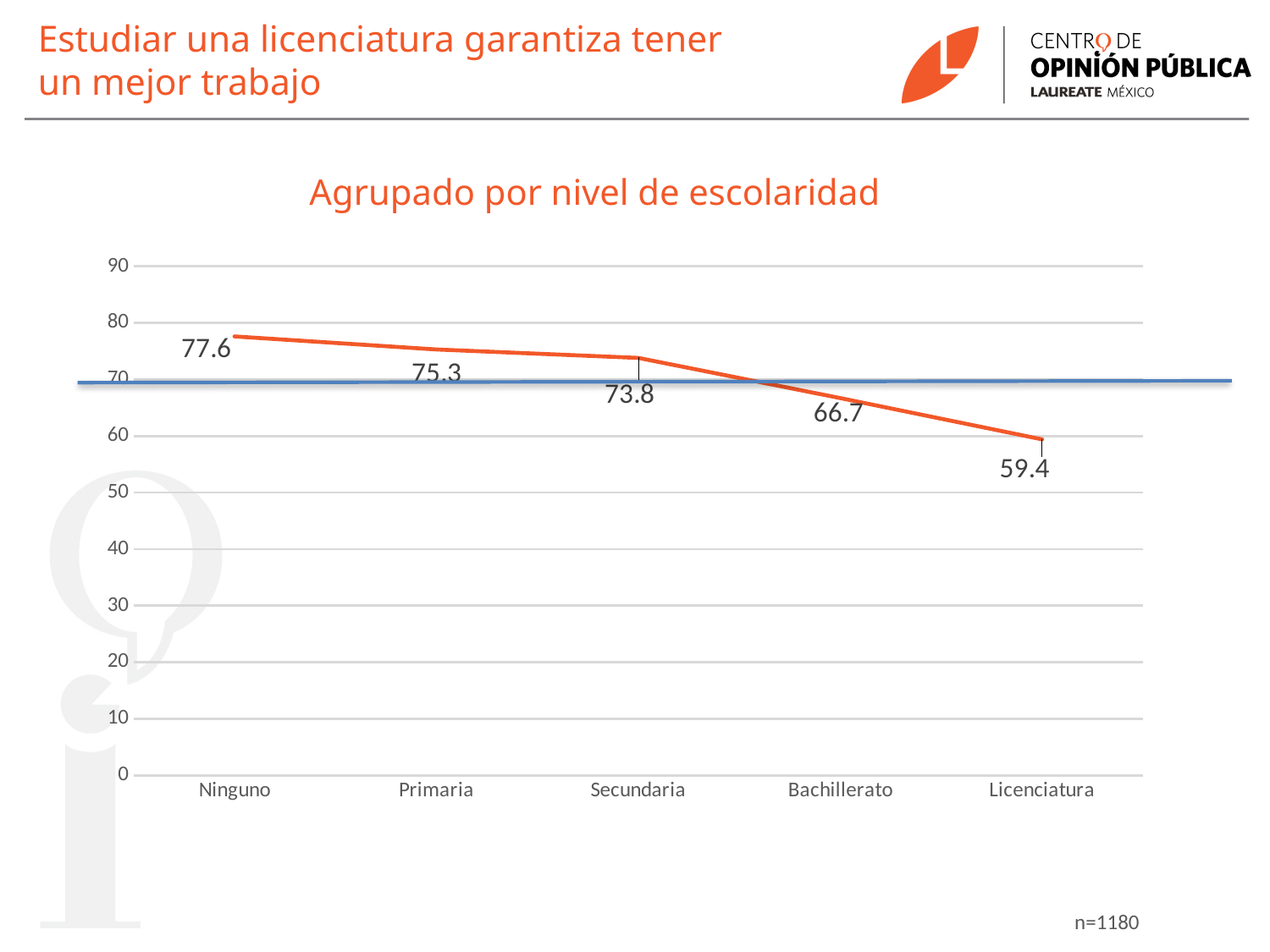
What is the value for Ninguno? 77.6 What is the value for Primaria? 75.3 What is the value for Bachillerato? 66.7 What is the difference between the values for Ninguno and Licenciatura? 18.2 What is the value for Secundaria? 73.8 What is the value for Licenciatura? 59.4 Which education level has the highest value? Ninguno What kind of chart is shown on the slide? Line chart Which is larger, the value for Secundaria or the value for Bachillerato? Secundaria Do the values rise or fall from Ninguno to Licenciatura? Fall How many education levels are shown on the x axis? 5 Which education level has the lowest value? Licenciatura